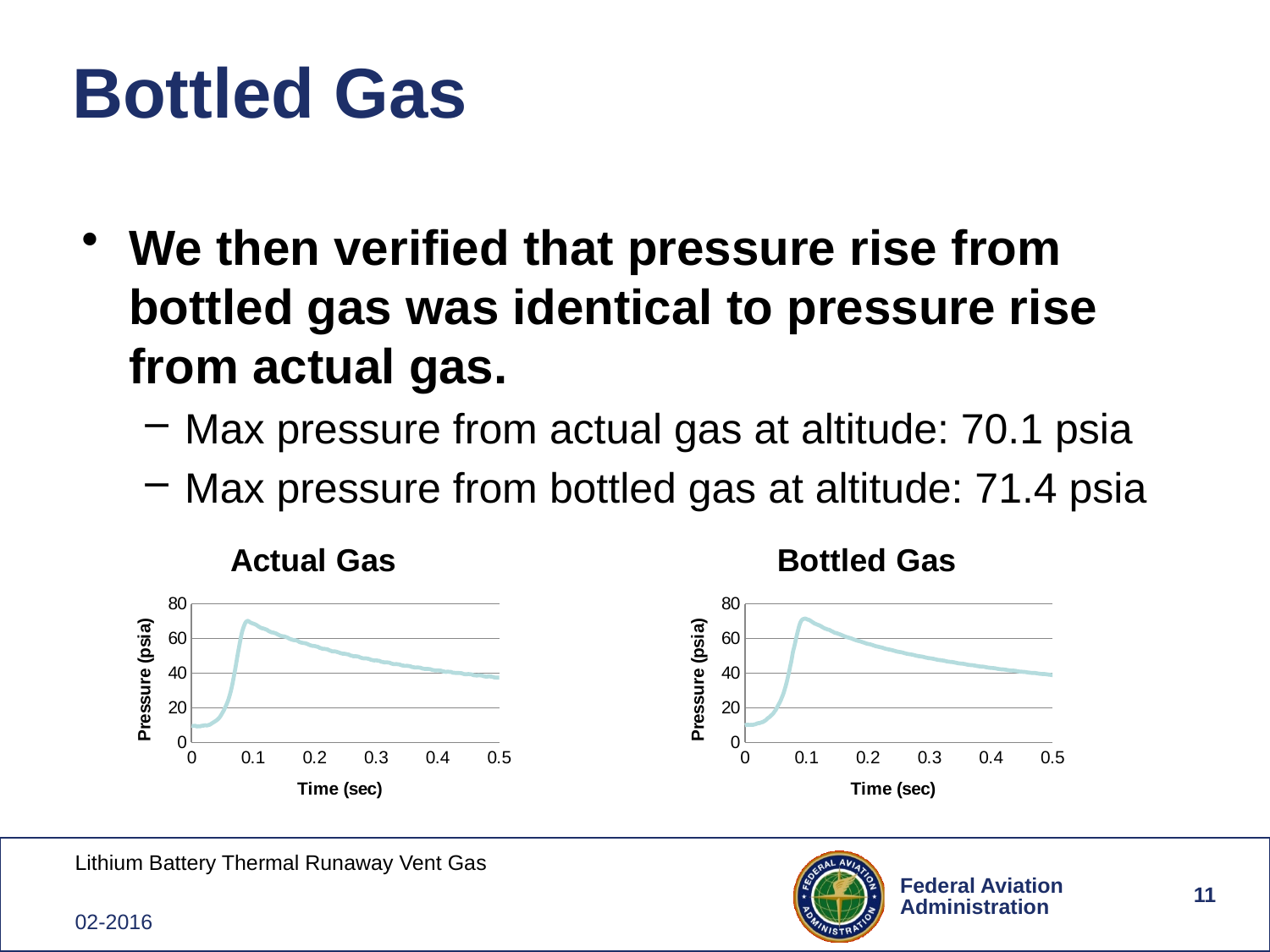
In the Actual Gas chart, what is the label of the y axis? Pressure (psia) According to the slide, what is the max pressure from bottled gas at altitude? 71.4 psia In the Actual Gas chart, is the peak pressure greater or less than 60? greater How many charts are shown on the slide? 2 In the Bottled Gas chart, does the pressure rise or fall between 0.1 sec and 0.5 sec? fall In the Bottled Gas chart, what is the label of the x axis? Time (sec) What kind of chart is the Actual Gas chart? line chart In the Actual Gas chart, is the pressure at 0.3 sec greater or less than 60? less According to the slide, what is the max pressure from actual gas at altitude? 70.1 psia In the Bottled Gas chart, is the pressure at time 0 greater or less than 20? less Which has the higher max pressure at altitude, actual gas or bottled gas? bottled gas